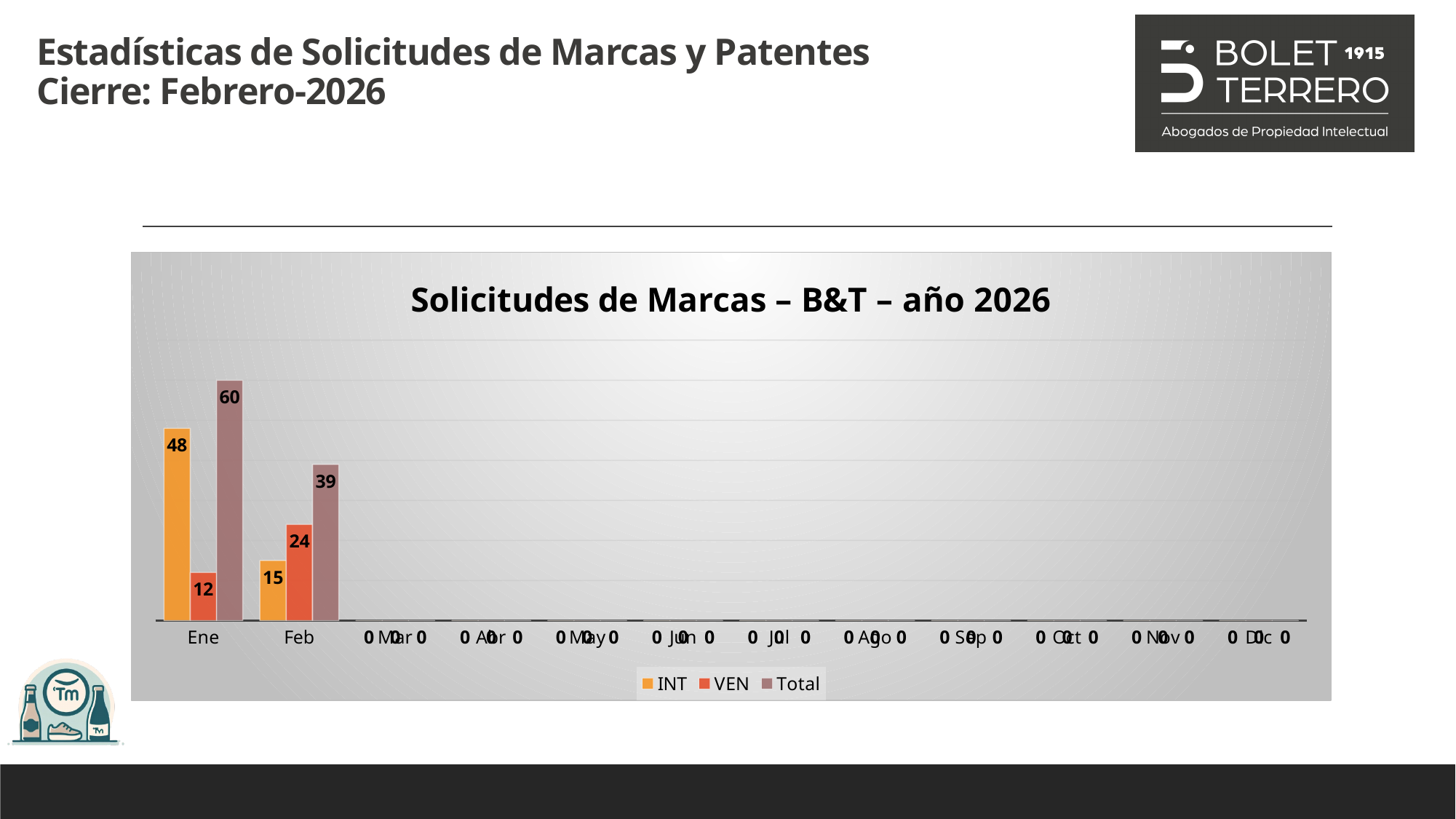
How many months are shown on the x axis? 12 What is the title of the chart? Solicitudes de Marcas – B&T – año 2026 What is the VEN value for Feb? 24 What is the Total value for Ene? 60 Which month has the highest Total value? Ene What is the INT value for Ene? 48 What is the difference between the INT values for Ene and Feb? 33 How many series does the legend list? 3 What kind of chart is shown? bar chart Which is larger, the VEN value for Ene or the VEN value for Feb? Feb What is the Total value for Feb? 39 What is the difference between the Total values for Ene and Feb? 21